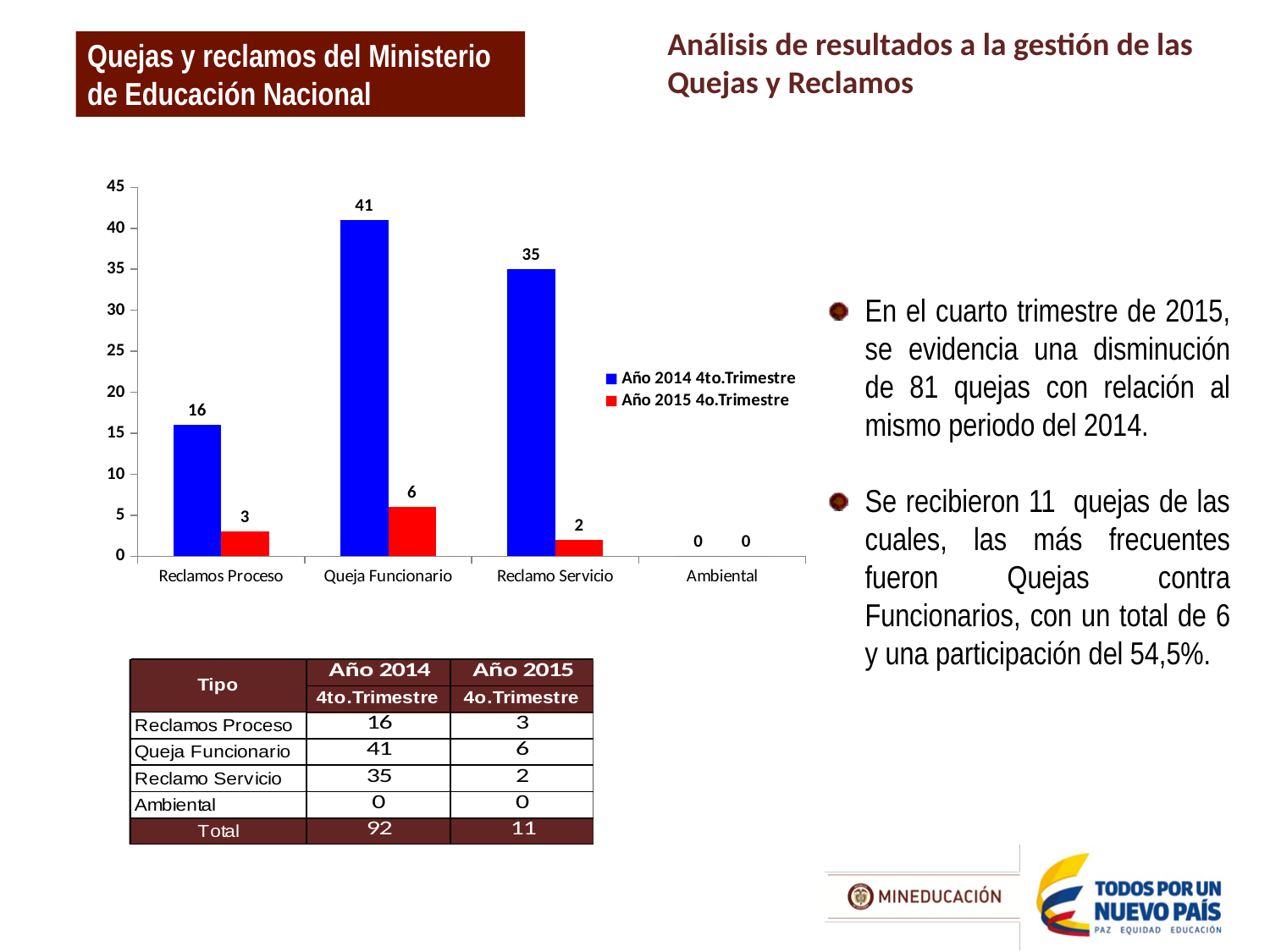
Which category has the highest value in the Año 2014 4to.Trimestre series? Queja Funcionario What is the value for Queja Funcionario in the Año 2014 4to.Trimestre series? 41 How many categories are shown on the x axis of the chart? 4 What is the difference between the Año 2014 4to.Trimestre and Año 2015 4o.Trimestre values for Queja Funcionario? 35 What is the value for Reclamo Servicio in the Año 2015 4o.Trimestre series? 2 What is the value for Reclamos Proceso in the Año 2014 4to.Trimestre series? 16 Which is larger: the Año 2015 4o.Trimestre value for Reclamos Proceso or for Queja Funcionario? Queja Funcionario What colour are the bars for the Año 2015 4o.Trimestre series? Red Is the Año 2014 4to.Trimestre value for Reclamo Servicio greater or less than 30? greater Which category has the lowest value in the Año 2015 4o.Trimestre series? Ambiental How many series does the chart legend list? 2 What kind of chart is shown on the slide? Bar chart